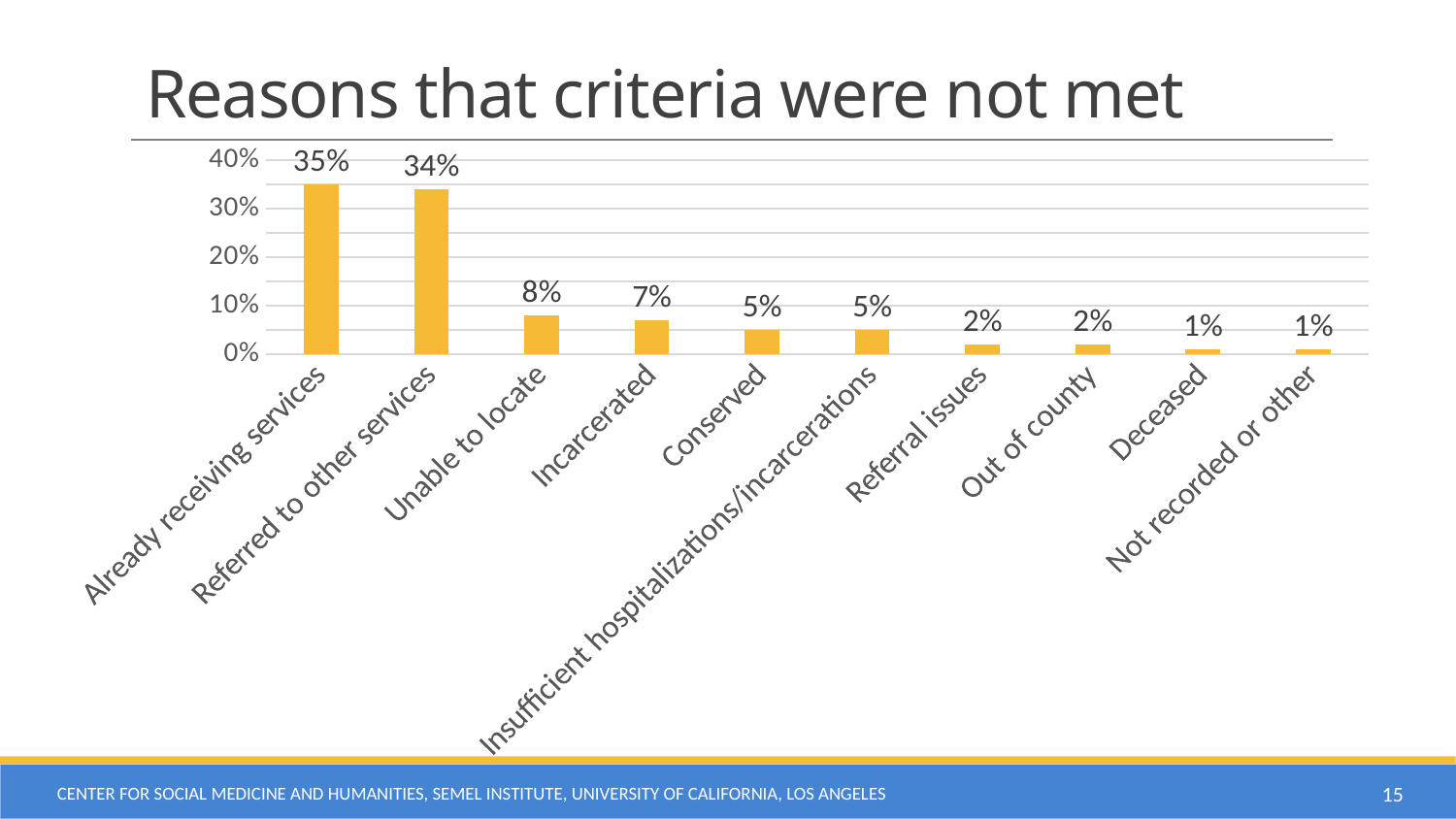
How many categories are shown on the x axis? 10 What is the difference between 'Already receiving services' and 'Referred to other services'? 1% Which category has the highest value? Already receiving services Is the value for 'Referred to other services' greater or less than 30%? greater What percentage is shown for 'Out of county'? 2% What percentage is shown for 'Already receiving services'? 35% What kind of chart is shown on the slide? Bar chart What percentage is shown for 'Incarcerated'? 7% What is the title of the chart? Reasons that criteria were not met What percentage is shown for 'Unable to locate'? 8% Which is larger, 'Incarcerated' or 'Referral issues'? Incarcerated What is the difference between 'Unable to locate' and 'Conserved'? 3%